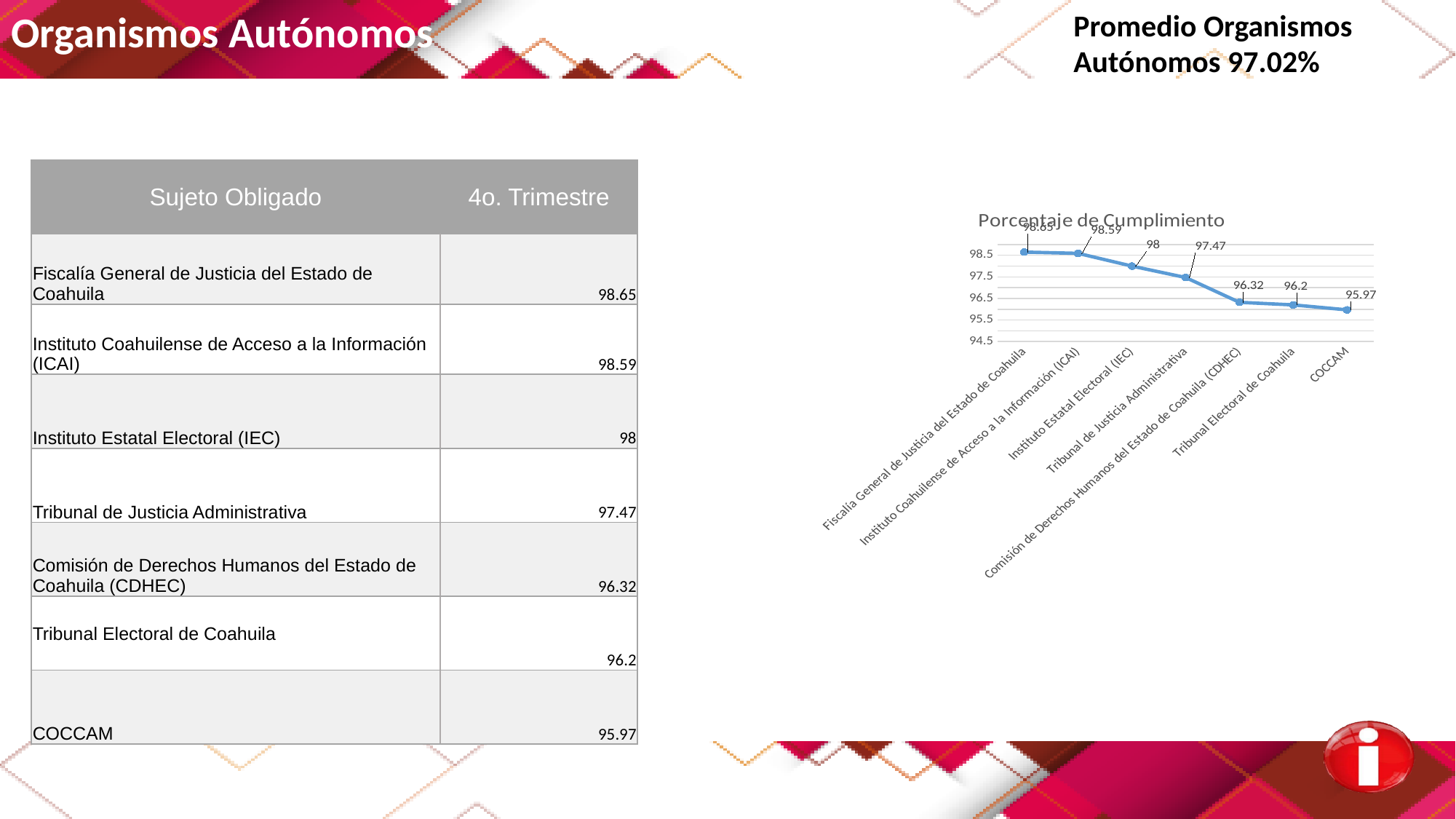
Is the value for Tribunal de Justicia Administrativa greater or less than 97.5? less What is the value for COCCAM in the chart? 95.97 Do the values rise or fall from left to right along the x axis? fall Which category has the highest value in the chart? Fiscalía General de Justicia del Estado de Coahuila How many data points are plotted in the chart? 7 What is the difference between the values for Fiscalía General de Justicia del Estado de Coahuila and COCCAM? 2.68 What is the value for Instituto Estatal Electoral (IEC) in the chart? 98 Which is larger, the value for Comisión de Derechos Humanos del Estado de Coahuila (CDHEC) or the value for Tribunal Electoral de Coahuila? Comisión de Derechos Humanos del Estado de Coahuila (CDHEC) What kind of chart is shown on the slide? line chart What is the title of the chart? Porcentaje de Cumplimiento Which category has the lowest value in the chart? COCCAM What is the value for Tribunal de Justicia Administrativa in the chart? 97.47